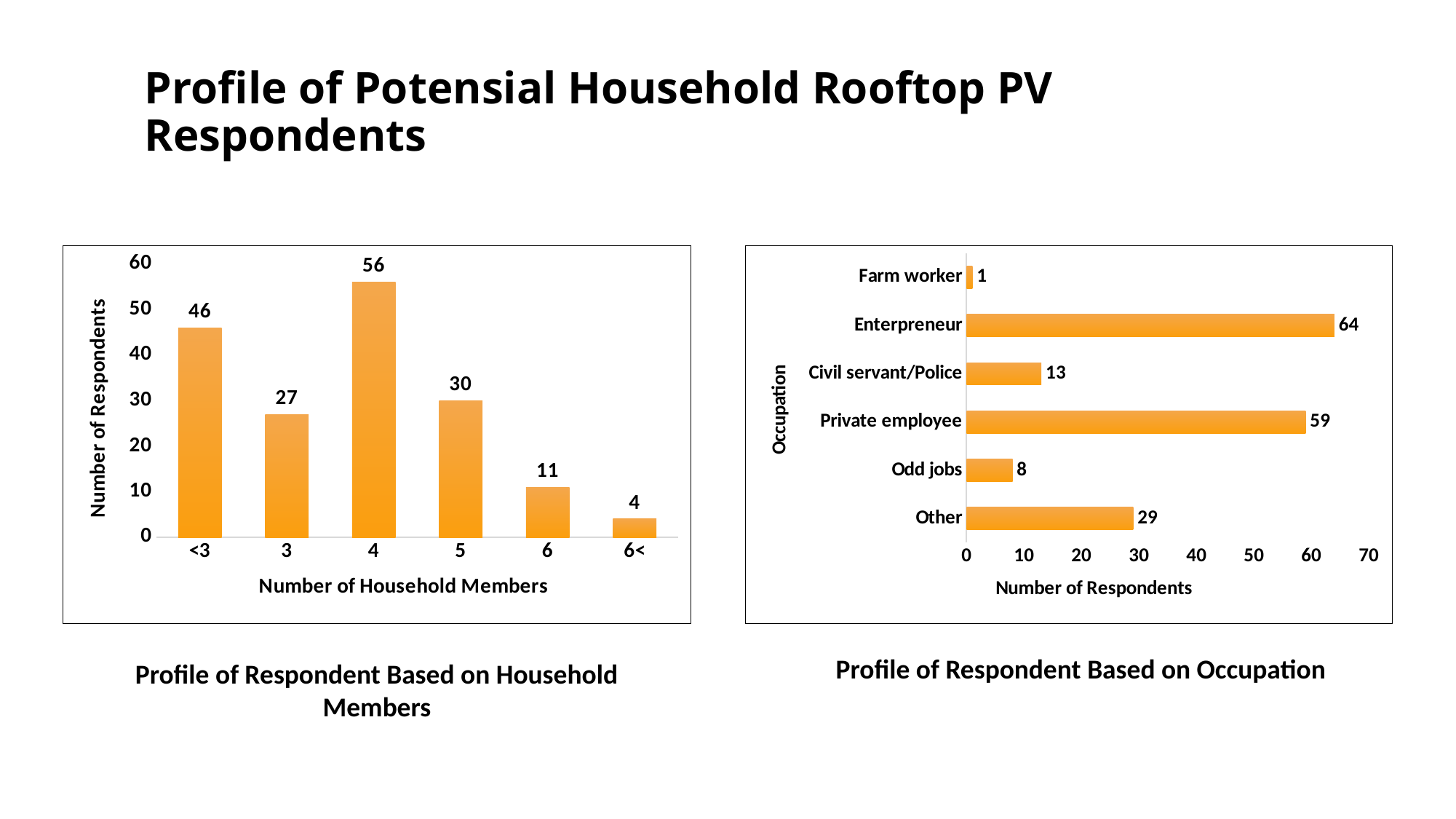
In the 'Profile of Respondent Based on Household Members' chart, how many respondents have 4 household members? 56 In the 'Profile of Respondent Based on Occupation' chart, how many respondents are civil servants/police? 13 What type of chart is the 'Profile of Respondent Based on Occupation' chart? Bar chart In the 'Profile of Respondent Based on Occupation' chart, which occupation has the most respondents? Enterpreneur In the 'Profile of Respondent Based on Occupation' chart, which has more respondents: Private employee or Other? Private employee In the 'Profile of Respondent Based on Household Members' chart, what is the label of the y axis? Number of Respondents In the 'Profile of Respondent Based on Household Members' chart, how many household size categories are shown? 6 In the 'Profile of Respondent Based on Household Members' chart, what is the difference between the number of respondents with 4 household members and those with 5? 26 In the 'Profile of Respondent Based on Household Members' chart, which household size category has the highest number of respondents? 4 In the 'Profile of Respondent Based on Household Members' chart, which household size category has the lowest number of respondents? 6< In the 'Profile of Respondent Based on Occupation' chart, what is the difference between the number of Enterpreneur respondents and Private employee respondents? 5 In the 'Profile of Respondent Based on Occupation' chart, which occupation has the fewest respondents? Farm worker